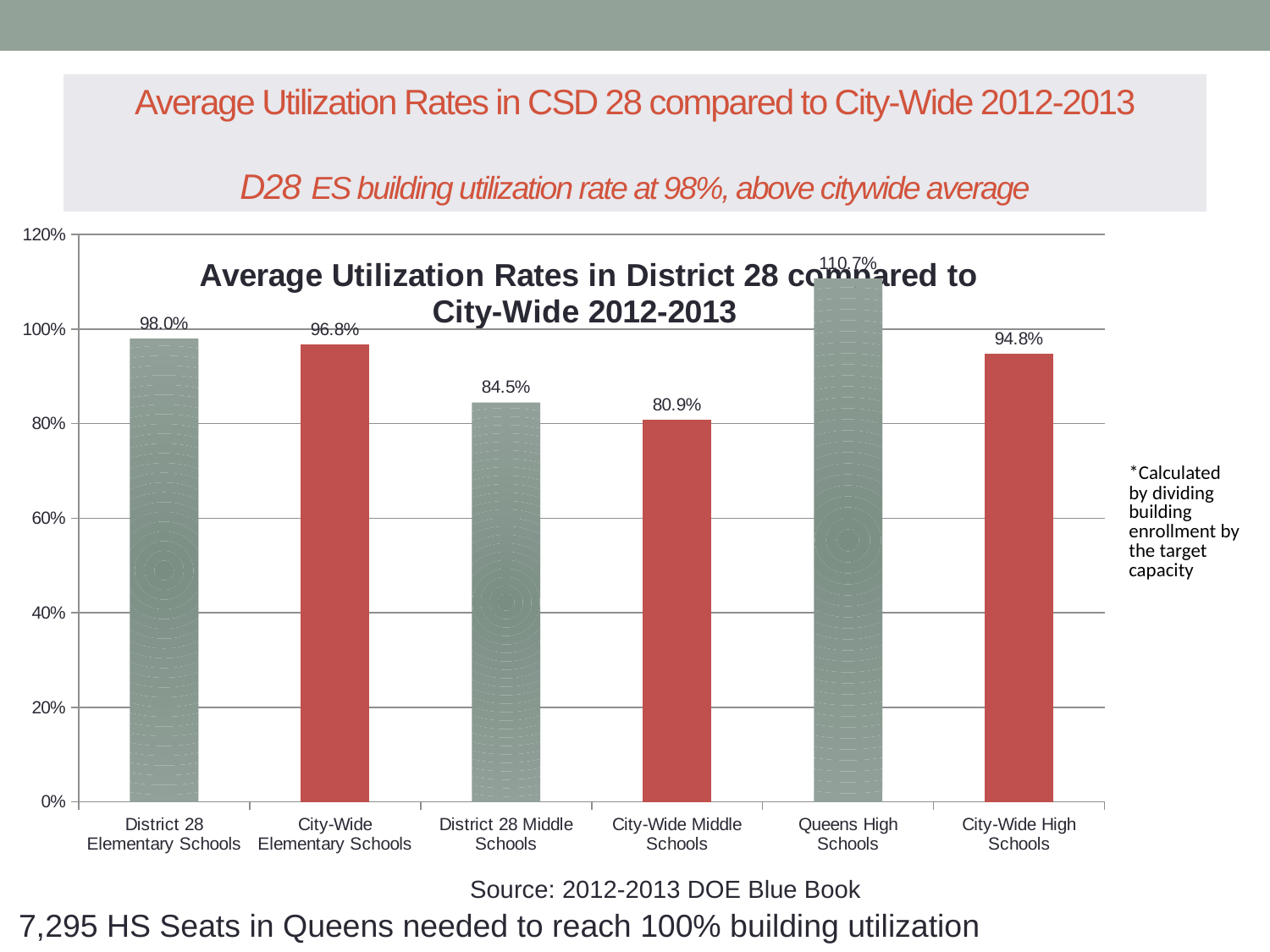
What is the average utilization rate for City-Wide Middle Schools? 80.9% What is the average utilization rate for Queens High Schools? 110.7% Which category has the lowest utilization rate? City-Wide Middle Schools What type of chart is shown on the slide? Bar chart What is the difference between the utilization rates of Queens High Schools and City-Wide High Schools? 15.9% What is the average utilization rate for City-Wide High Schools? 94.8% What is the difference between the utilization rates of District 28 Middle Schools and City-Wide Middle Schools? 3.6% Is the utilization rate for Queens High Schools greater or less than 100%? greater How many categories are shown on the x axis of the chart? 6 What is the average utilization rate for District 28 Elementary Schools? 98.0% Which has a higher utilization rate, District 28 Elementary Schools or City-Wide Elementary Schools? District 28 Elementary Schools Which category has the highest utilization rate? Queens High Schools